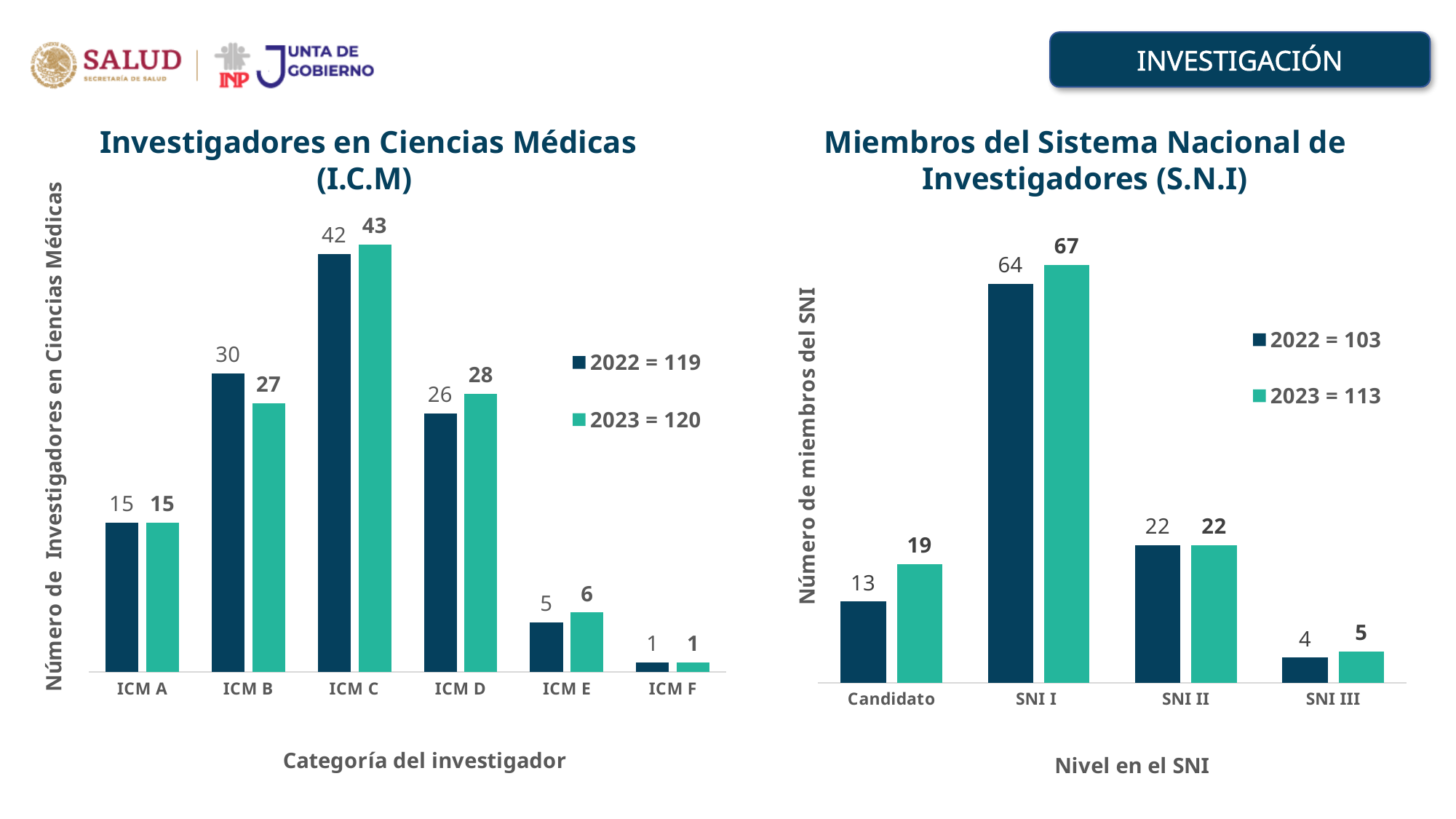
In the 'Miembros del Sistema Nacional de Investigadores (S.N.I)' chart, what is the value for Candidato in 2023? 19 In the 'Investigadores en Ciencias Médicas (I.C.M)' chart, which category has the highest value in 2022? ICM C In the 'Investigadores en Ciencias Médicas (I.C.M)' chart, how many categories are shown on the x axis? 6 What kind of chart is the 'Miembros del Sistema Nacional de Investigadores (S.N.I)' chart? Bar chart In the 'Miembros del Sistema Nacional de Investigadores (S.N.I)' chart, what is the value for SNI I in 2022? 64 In the 'Investigadores en Ciencias Médicas (I.C.M)' chart, what is the value for ICM B in 2022? 30 In the 'Investigadores en Ciencias Médicas (I.C.M)' chart, which category has the lowest value in 2023? ICM F In the 'Miembros del Sistema Nacional de Investigadores (S.N.I)' chart, is the 2022 value for SNI I larger or the 2022 value for SNI II? SNI I In the 'Investigadores en Ciencias Médicas (I.C.M)' chart, what is the value for ICM C in 2023? 43 In the 'Investigadores en Ciencias Médicas (I.C.M)' chart, what is the difference between the 2022 and 2023 values for ICM B? 3 In the 'Miembros del Sistema Nacional de Investigadores (S.N.I)' chart, which level has the highest value in 2023? SNI I In the 'Miembros del Sistema Nacional de Investigadores (S.N.I)' chart, what is the difference between the 2023 and 2022 values for Candidato? 6